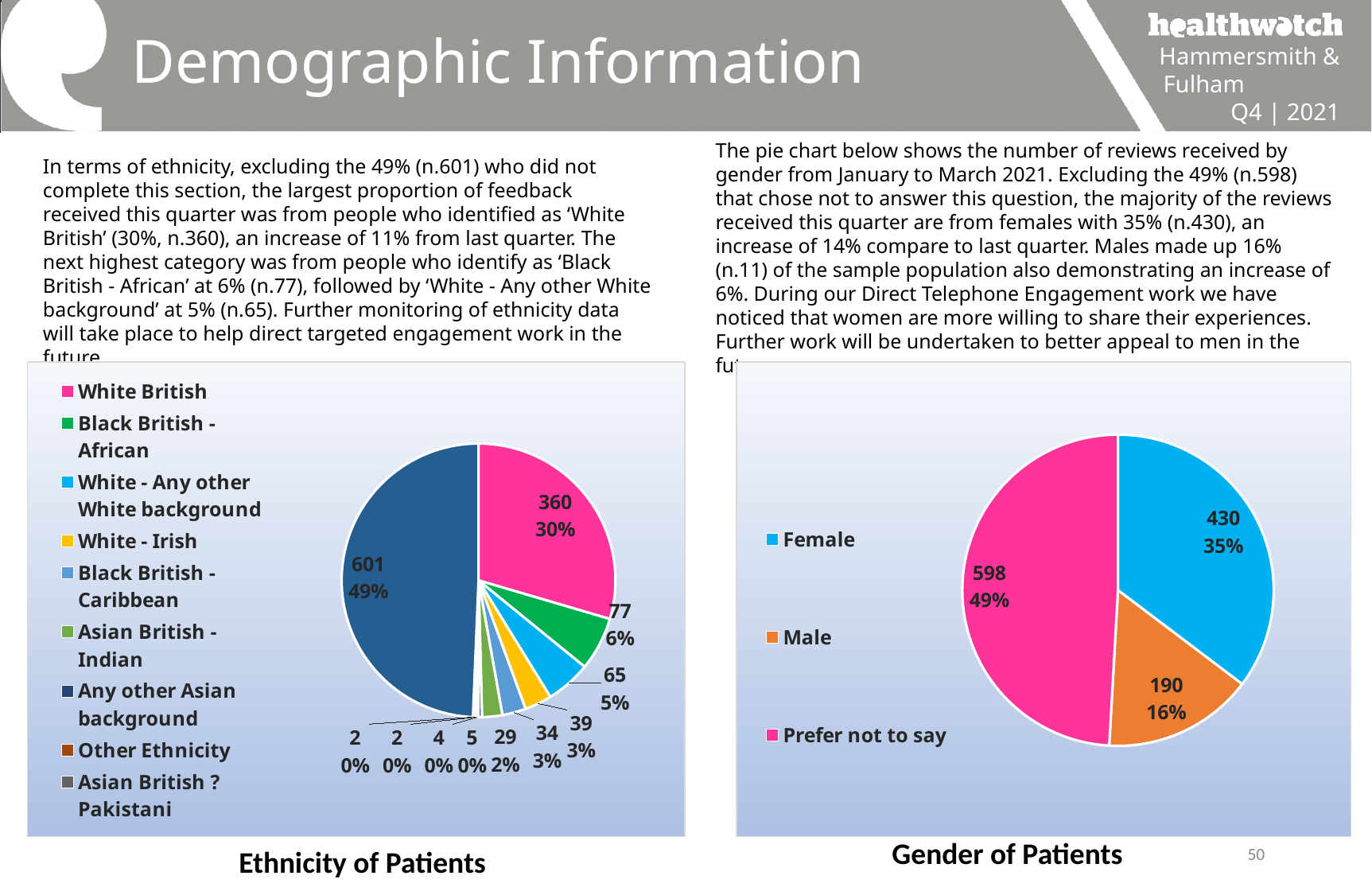
In the Gender of Patients chart, what share of the pie is Male? 16% What kind of chart is the Gender of Patients chart? Pie chart In the Gender of Patients chart, what is the difference between the Female and Male counts? 240 In the Gender of Patients chart, what is the total of the three slices (Female, Male and Prefer not to say)? 1218 In the Ethnicity of Patients chart, how many patients identified as White British? 360 In the Gender of Patients chart, which category has the smallest slice? Male In the Ethnicity of Patients chart, what share of the pie is Black British - African? 6% How many entries does the legend of the Gender of Patients chart list? 3 In the Ethnicity of Patients chart, what is the count for White - Any other White background? 65 In the Ethnicity of Patients chart, which is larger: White British or Black British - African? White British In the Gender of Patients chart, how many reviews were from Female respondents? 430 In the Gender of Patients chart, which category has the largest slice? Prefer not to say